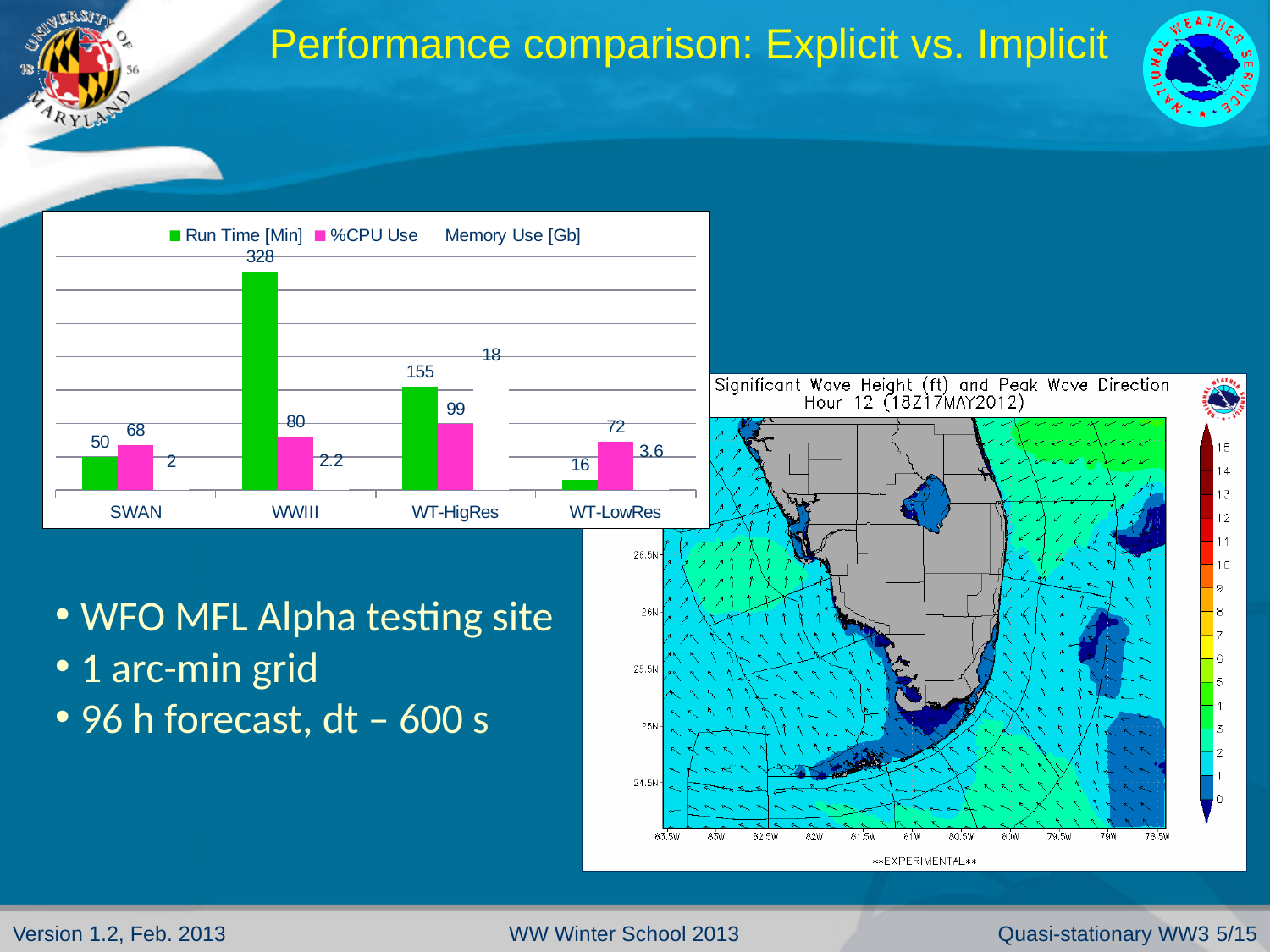
Which is larger, the %CPU Use for SWAN or for WT-LowRes? WT-LowRes What is the Run Time [Min] for WWIII? 328 How many categories are shown on the x axis of the chart? 4 What is the Run Time [Min] for SWAN? 50 Which category has the highest Memory Use [Gb]? WT-HigRes How many series does the chart legend list? 3 What is the %CPU Use for WT-HigRes? 99 What is the difference in Run Time [Min] between WWIII and WT-HigRes? 173 What is the Memory Use [Gb] for WT-LowRes? 3.6 Which category has the lowest Run Time [Min]? WT-LowRes What kind of chart is shown on the slide? bar chart Which category has the highest Run Time [Min]? WWIII